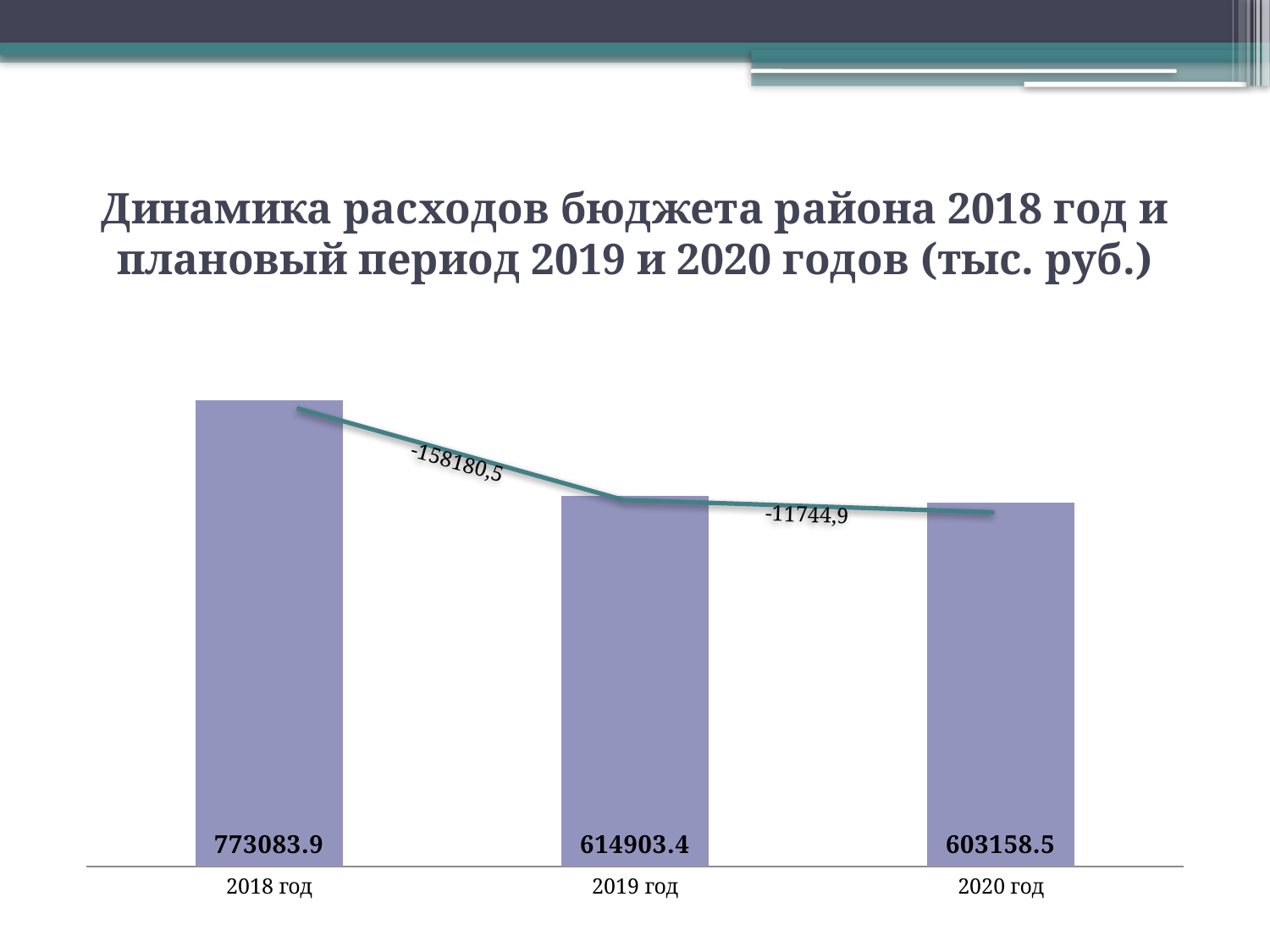
Do the values rise or fall from 2018 год to 2020 год? fall Which year has the highest value? 2018 год What change is labelled on the line between 2018 год and 2019 год? -158180,5 How many years are shown on the chart? 3 Which year has the lowest value? 2020 год What is the value for 2020 год? 603158.5 What is the difference between the values for 2018 год and 2019 год? 158180.5 What is the value for 2019 год? 614903.4 What kind of chart is this? bar chart What is the difference between the values for 2019 год and 2020 год? 11744.9 Which is larger, the value for 2018 год or the value for 2020 год? 2018 год What is the value for 2018 год? 773083.9